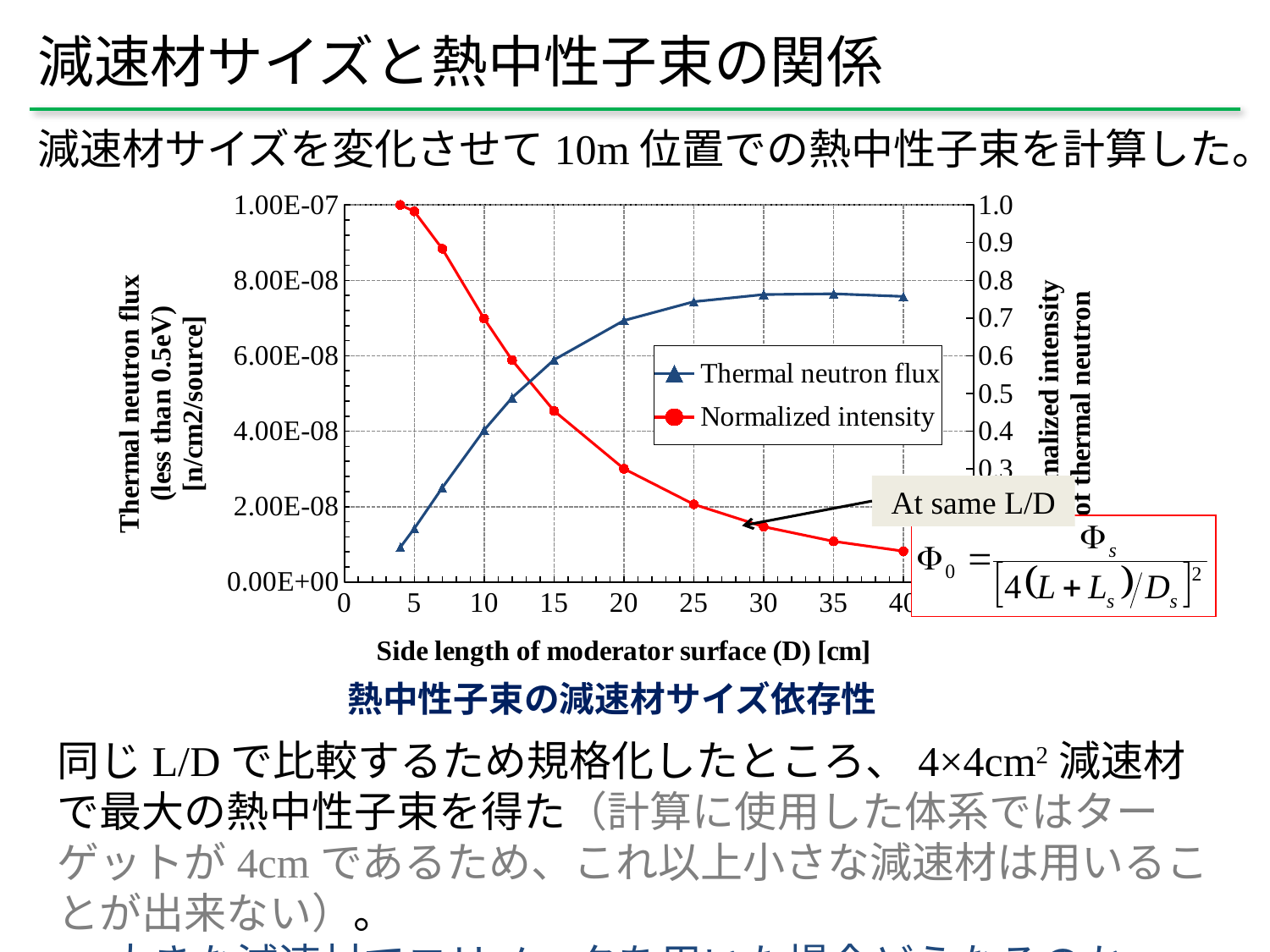
How many data points are plotted for the Normalized intensity series? 11 Does the Normalized intensity rise or fall as the side length D increases? fall What are the two series named in the chart legend? Thermal neutron flux; Normalized intensity Is the Thermal neutron flux at D = 40 cm greater or less than 6.00E-08? greater How many series does the chart legend list? 2 At which side length D is the Normalized intensity highest? 4 cm What is the Normalized intensity at D = 4 cm? 1.0 What is the x-axis title of the chart? Side length of moderator surface (D) [cm] What kind of chart is shown on the slide? line chart Does the Thermal neutron flux rise or fall as the side length D increases from 4 cm to 25 cm? rise Is the Normalized intensity at D = 20 cm greater or less than 0.4? less At which side length D is the Thermal neutron flux lowest? 4 cm